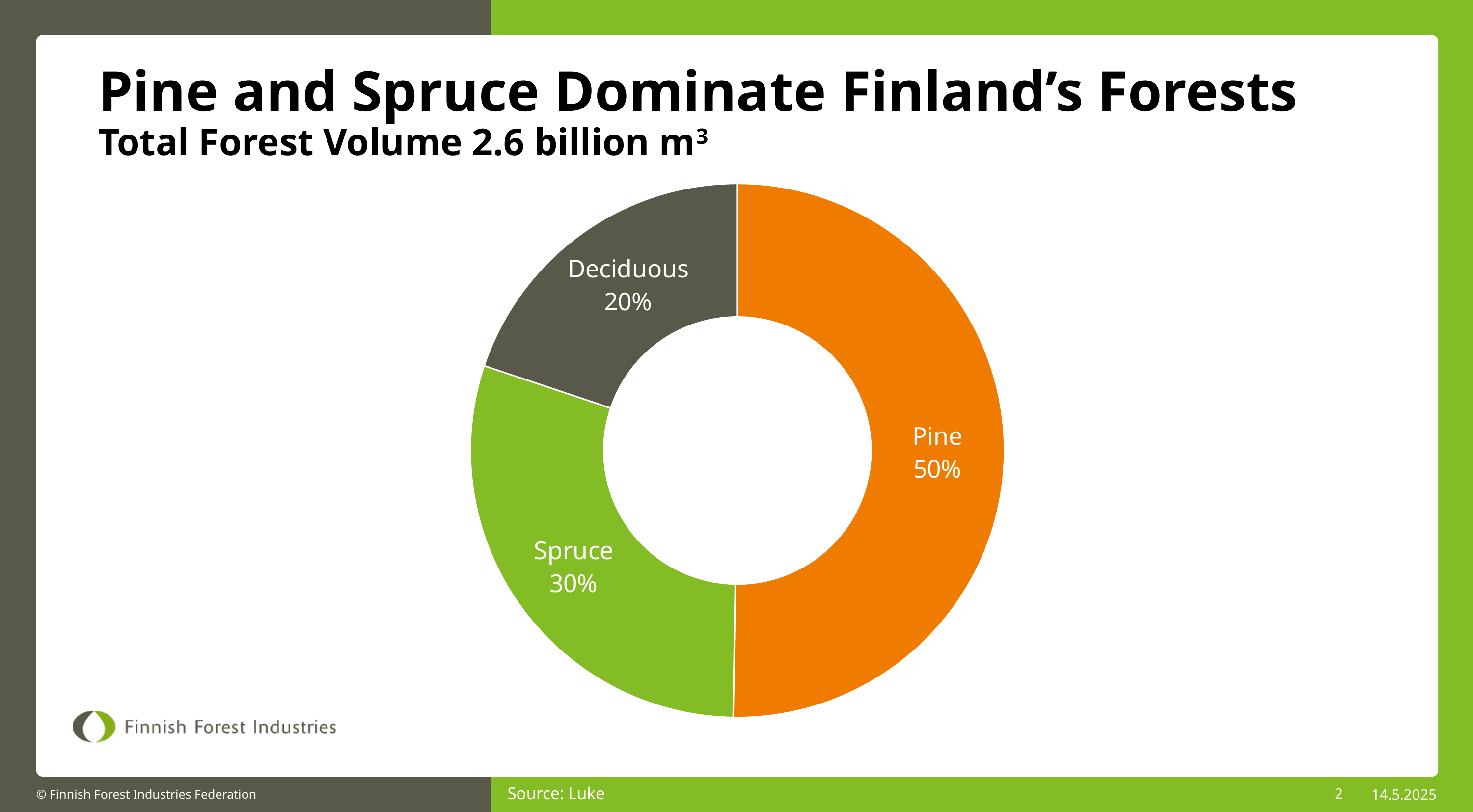
Which has a larger share, Spruce or Deciduous? Spruce How many categories are shown in the chart? 3 What share of Finland's forest volume is Deciduous? 20% How many percentage points larger is the Spruce share than the Deciduous share? 10 What is the combined share of Pine and Spruce? 80% What colour is the Pine segment of the chart? Orange How many percentage points larger is the Pine share than the Spruce share? 20 What share of Finland's forest volume is Pine? 50% What kind of chart is shown on the slide? Doughnut (pie) chart Which tree type has the largest share of the forest volume? Pine Which tree type has the smallest share of the forest volume? Deciduous What share of Finland's forest volume is Spruce? 30%